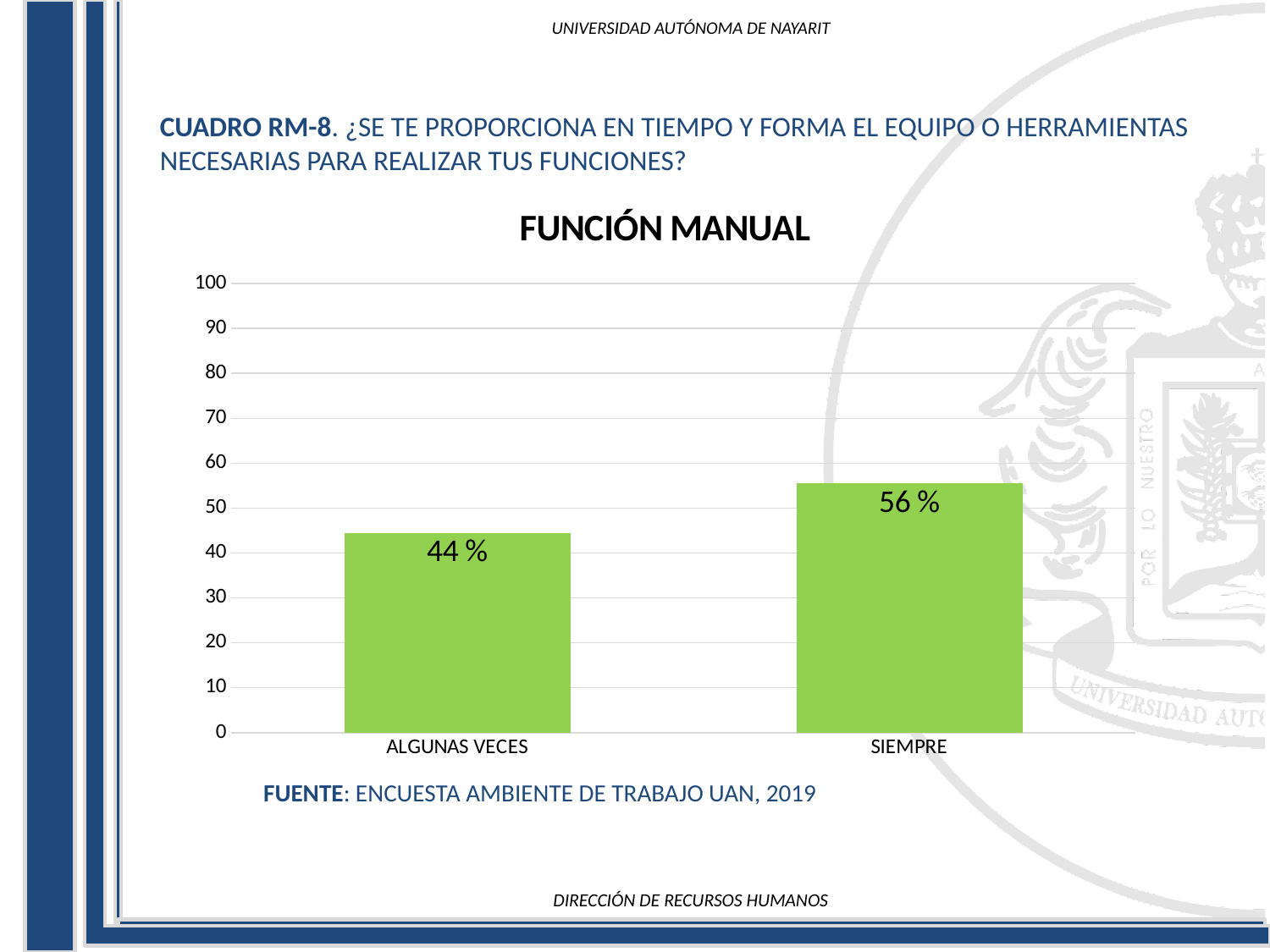
Which category has the highest value? SIEMPRE What is the difference between the values for SIEMPRE and ALGUNAS VECES? 12 % Is the value for ALGUNAS VECES greater or less than 50? less Which is larger, the value for ALGUNAS VECES or the value for SIEMPRE? SIEMPRE What kind of chart is shown on the slide? bar chart Which category has the lowest value? ALGUNAS VECES What colour are the bars in the chart? green What is the value for SIEMPRE? 56 % How many categories are shown on the x axis? 2 What is the value for ALGUNAS VECES? 44 % Is the value for SIEMPRE greater or less than 50? greater What is the title of the chart? FUNCIÓN MANUAL